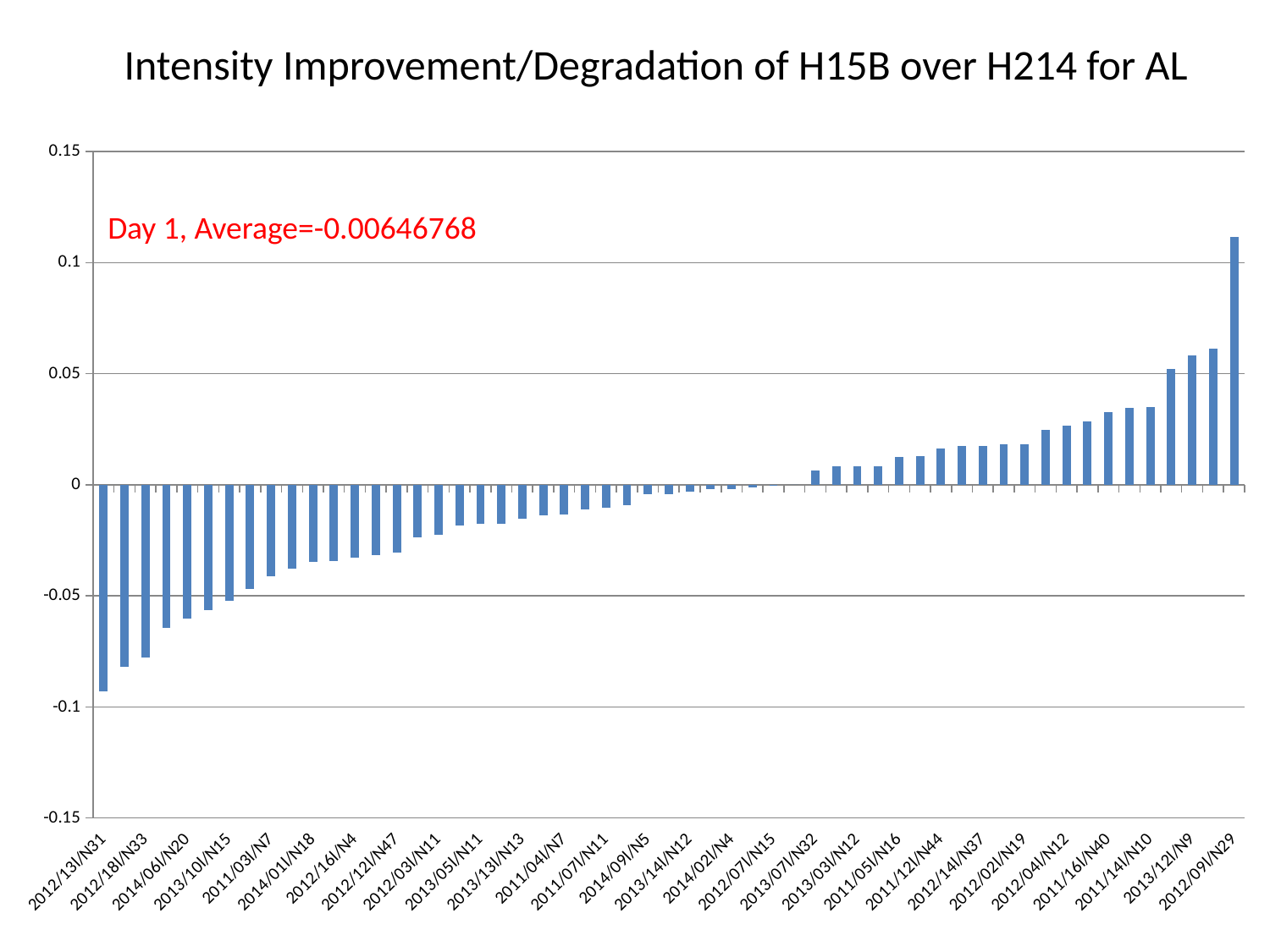
Is the value for 2013/12/N9 greater or less than 0.05? greater What is the title of the chart? Intensity Improvement/Degradation of H15B over H214 for AL Which category has the highest value? 2012/09l/N29 Do the values rise or fall moving left to right along the x axis? rise What average value is printed in the red annotation on the chart? -0.00646768 Is the value for 2012/13/N31 greater or less than -0.05? less Which category has the lowest value? 2012/13l/N31 Which has the larger value, 2012/09/N29 or 2012/13/N31? 2012/09l/N29 Is the value for 2012/18/N33 greater or less than -0.05? less What kind of chart is shown on the slide? bar chart